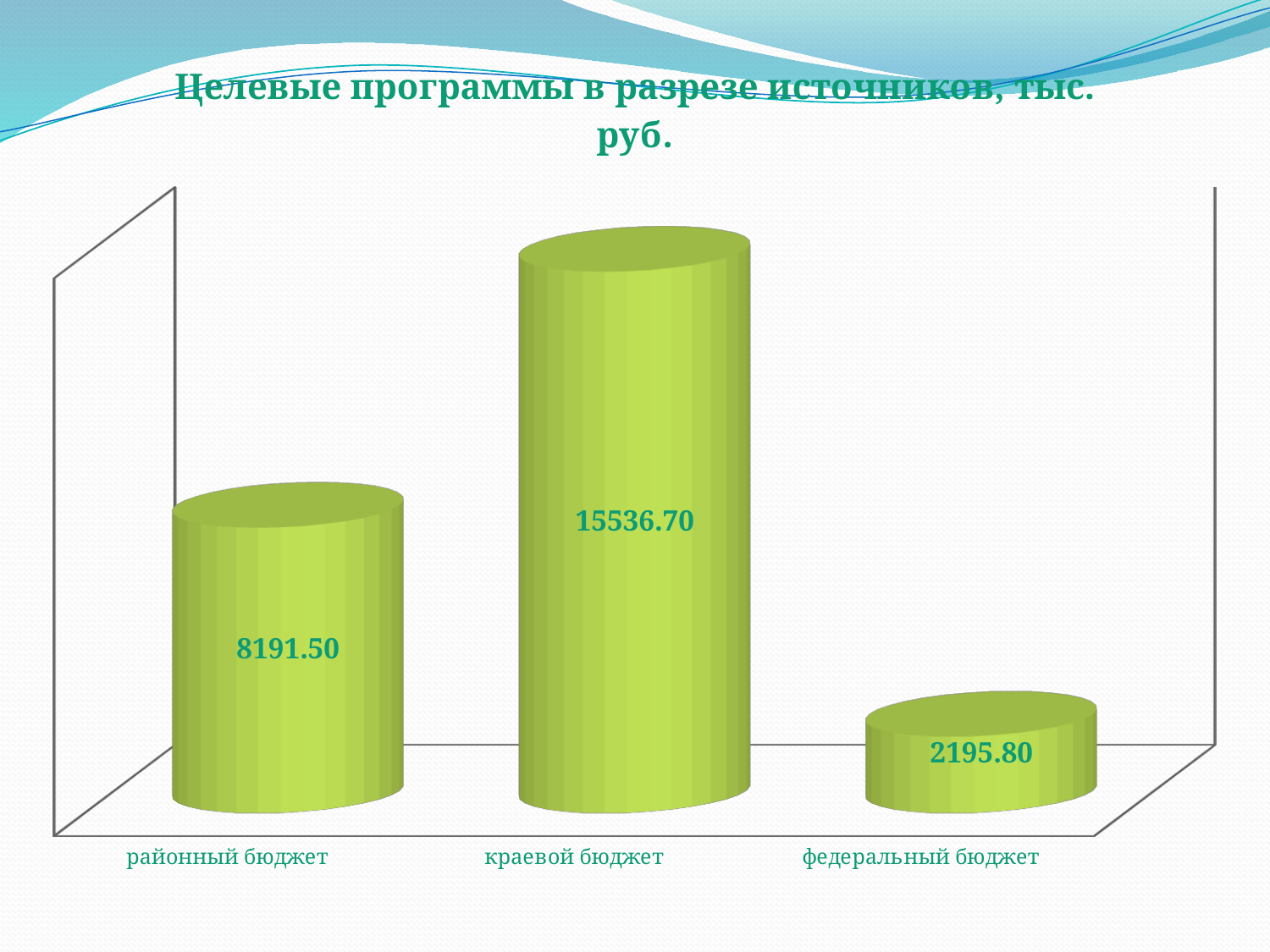
Which category has the lowest value? федеральный бюджет Which category has the highest value? краевой бюджет What unit is stated in the chart title? тыс. руб. What kind of chart is shown on the slide? bar chart What is the difference between the values for краевой бюджет and районный бюджет? 7345.20 What is the value for районный бюджет? 8191.50 Which is larger, the value for районный бюджет or the value for федеральный бюджет? районный бюджет How many categories are shown in the chart? 3 What is the value for краевой бюджет? 15536.70 What is the value for федеральный бюджет? 2195.80 What is the title of the chart? Целевые программы в разрезе источников, тыс. руб. What is the difference between the values for районный бюджет and федеральный бюджет? 5995.70